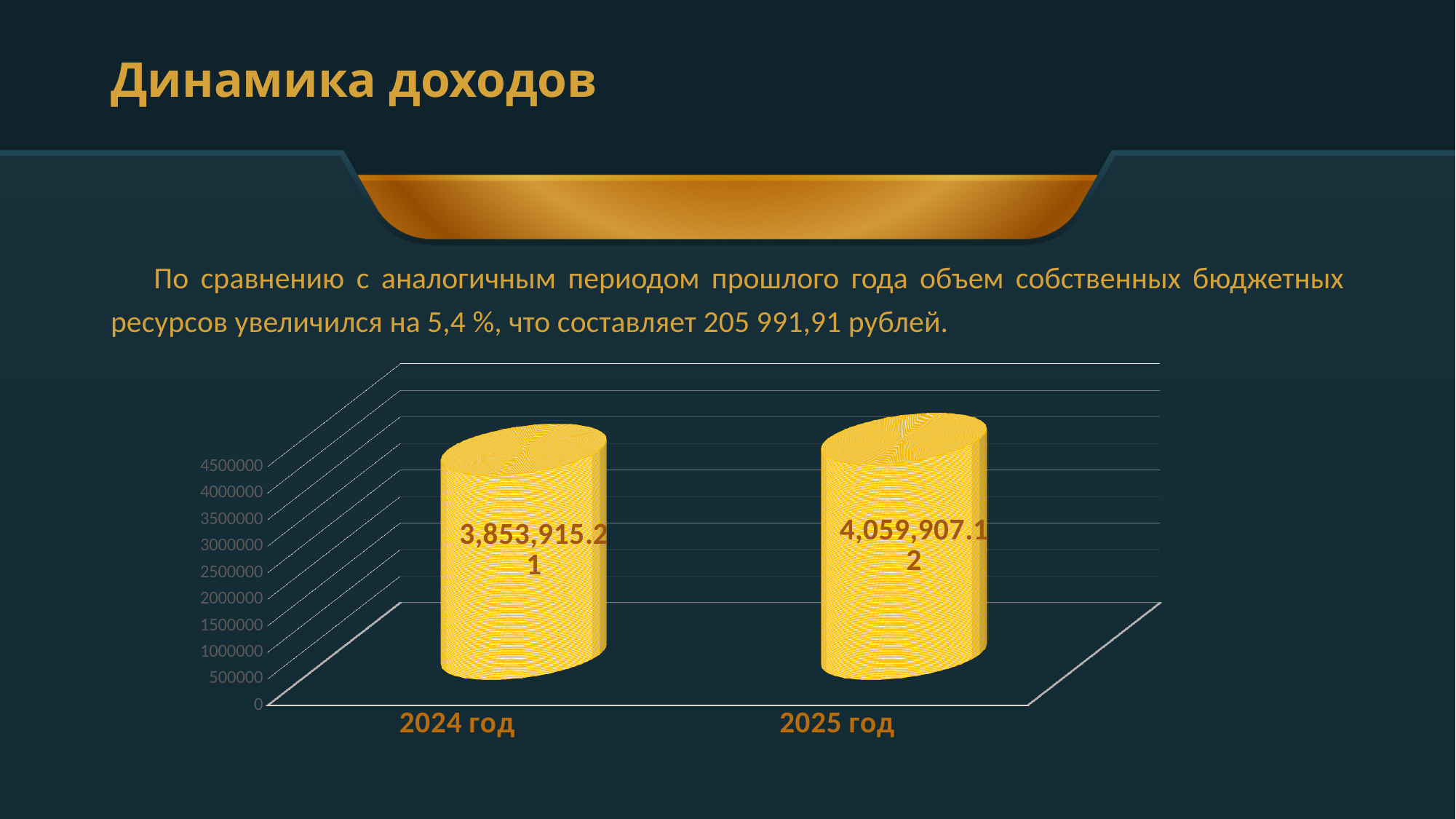
What kind of chart is shown on the slide? bar chart What is the difference between the values for 2025 год and 2024 год? 205,991.91 Is the value for 2025 год larger or smaller than the value for 2024 год? larger Is the value for 2025 год greater or less than 3500000? greater What is the title of the slide? Динамика доходов Which year has the lower value? 2024 год Is the value for 2024 год greater or less than 3000000? greater How many categories are shown on the x axis of the chart? 2 What is the value shown for 2025 год? 4,059,907.12 What is the value shown for 2024 год? 3,853,915.21 Which year has the higher value? 2025 год Do the values rise or fall from 2024 год to 2025 год? rise